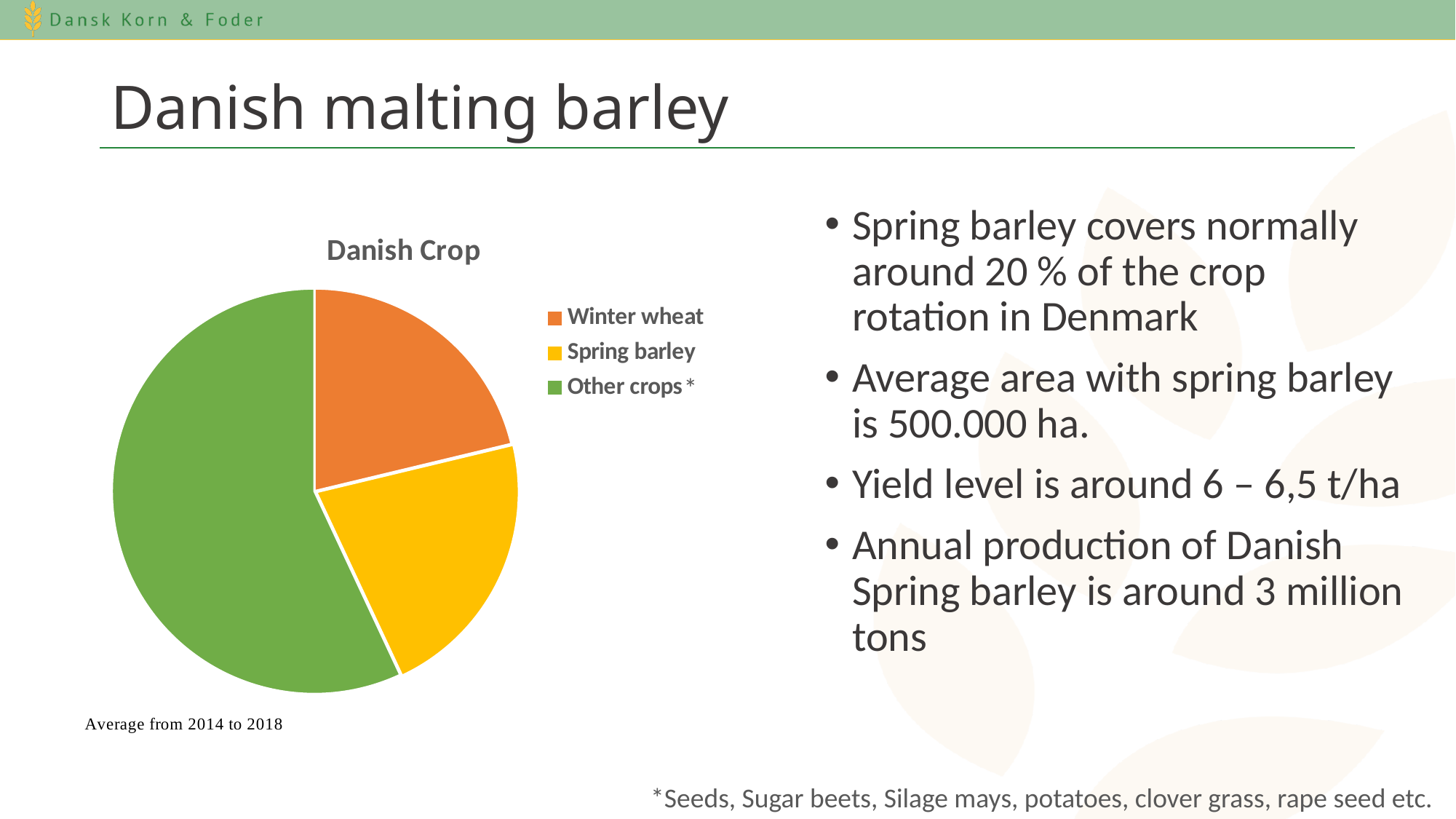
What is the title of the chart? Danish Crop Which slice is larger, Other crops or Winter wheat? Other crops Which category is shown in orange in the pie chart? Winter wheat Which category has the largest slice of the pie? Other crops Which colour represents Spring barley in the pie chart? Yellow Which slice is larger, Spring barley or Other crops? Other crops What kind of chart is shown on the slide? Pie chart How many slices does the pie chart have? 3 Which category is shown in green in the pie chart? Other crops Does the Other crops slice take up more or less than half of the pie? more How many entries does the chart legend list? 3